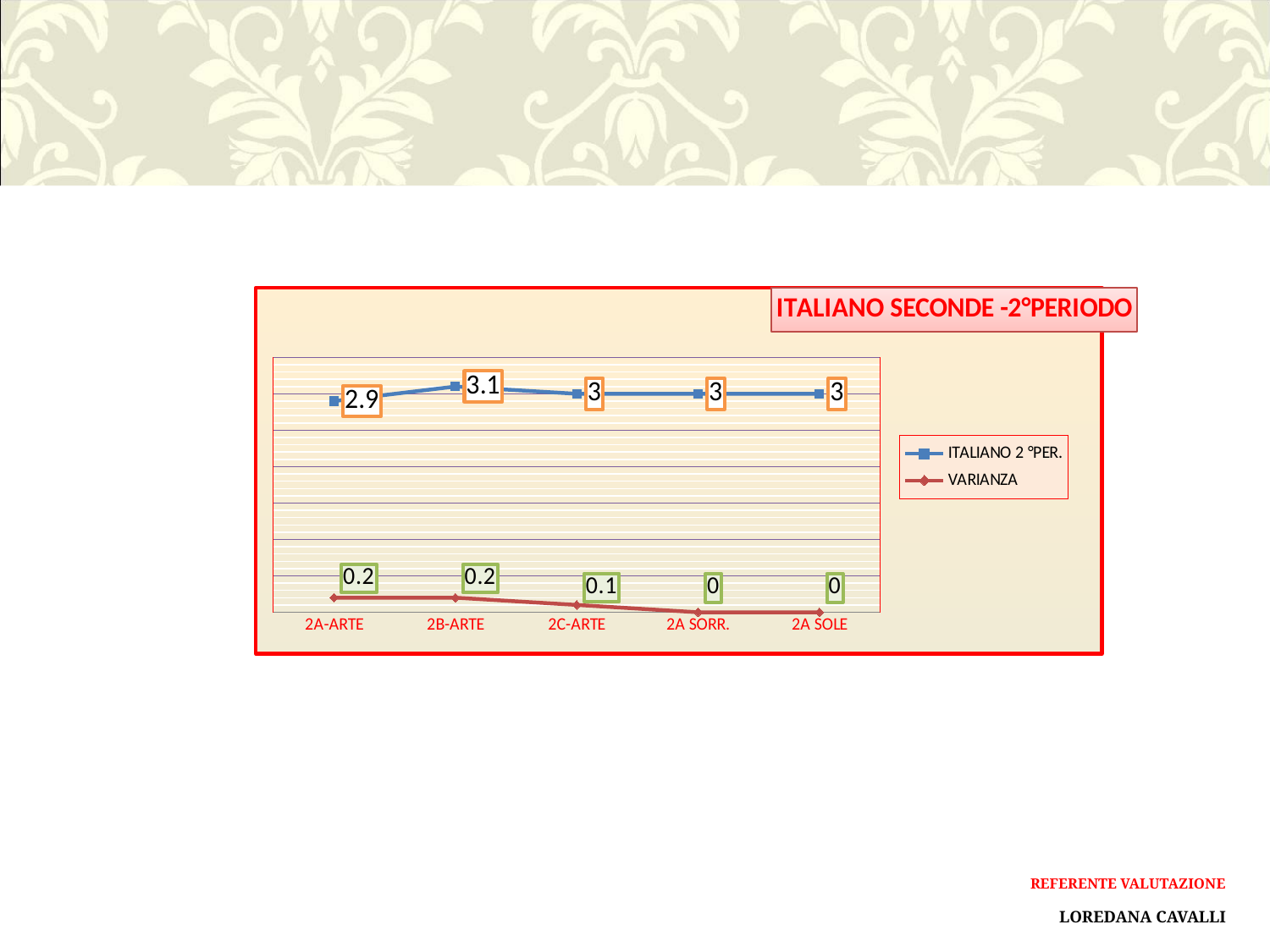
Which category has the lowest ITALIANO 2 °PER. value? 2A-ARTE What is the value of ITALIANO 2 °PER. for 2A-ARTE? 2.9 What is the difference between the ITALIANO 2 °PER. values for 2B-ARTE and 2A-ARTE? 0.2 How many series does the legend list? 2 Does the VARIANZA series rise or fall from 2B-ARTE to 2A SORR.? fall What is the title of the chart? ITALIANO SECONDE -2°PERIODO How many categories are shown on the x axis? 5 What is the value of ITALIANO 2 °PER. for 2B-ARTE? 3.1 Which category has the highest ITALIANO 2 °PER. value? 2B-ARTE What kind of chart is this? line chart Which is larger, the VARIANZA for 2A-ARTE or for 2C-ARTE? 2A-ARTE What is the VARIANZA value for 2C-ARTE? 0.1